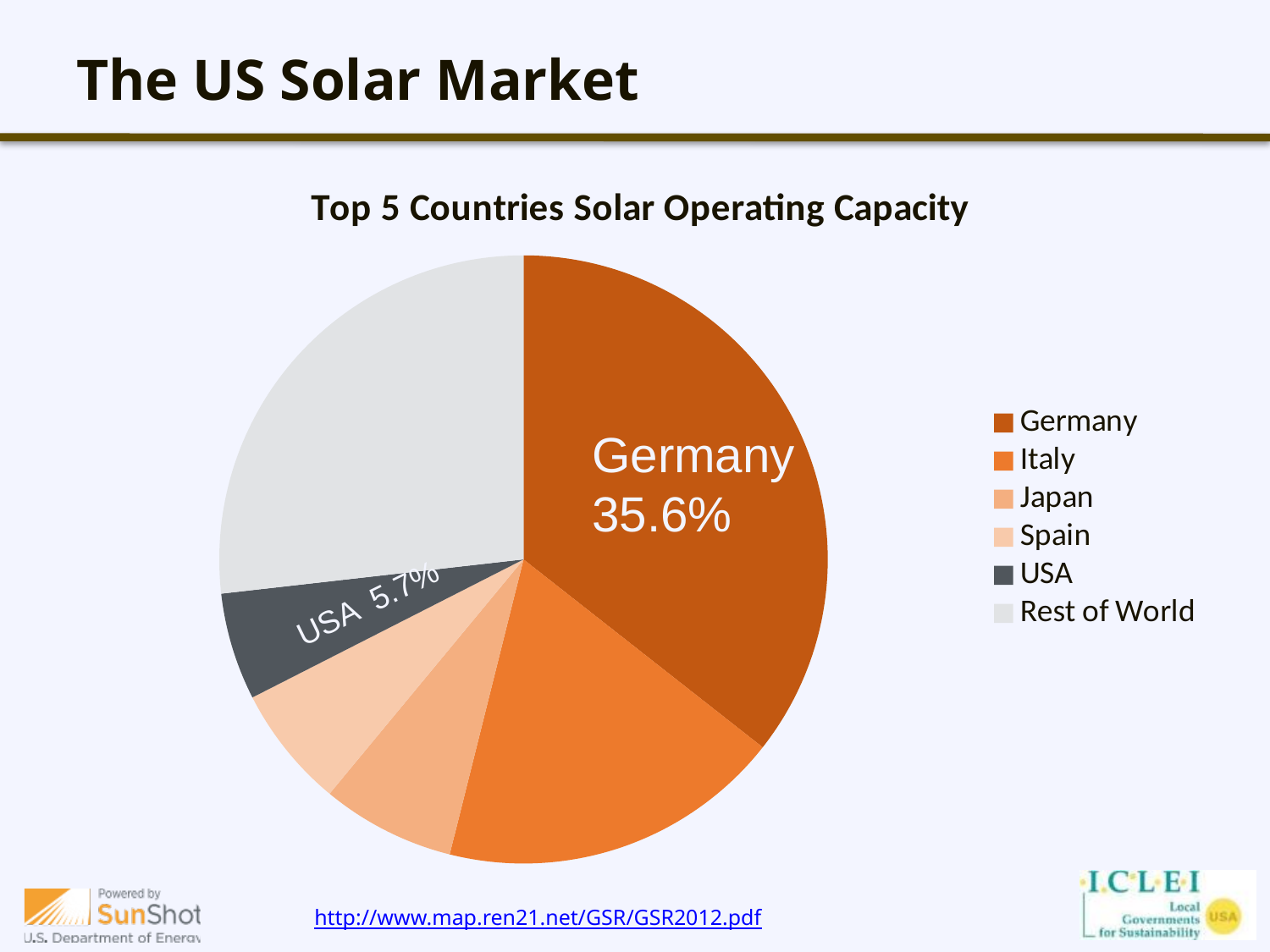
What percentage is shown for the USA slice? 5.7% Which is larger, the Germany slice or the Italy slice? Germany What share of the pie does Germany hold in the Top 5 Countries Solar Operating Capacity chart? 35.6% Which legend entry is shown in dark grey? USA How many slices does the pie chart have? 6 By how many percentage points does Germany's share exceed the USA's share? 29.9 percentage points What is the title of the pie chart? Top 5 Countries Solar Operating Capacity What kind of chart is shown on the slide? Pie chart Which is larger, the Germany slice or the Rest of World slice? Germany Which slice is the largest in the pie chart? Germany How many entries does the legend list? 6 Which is larger, the Italy slice or the Japan slice? Italy